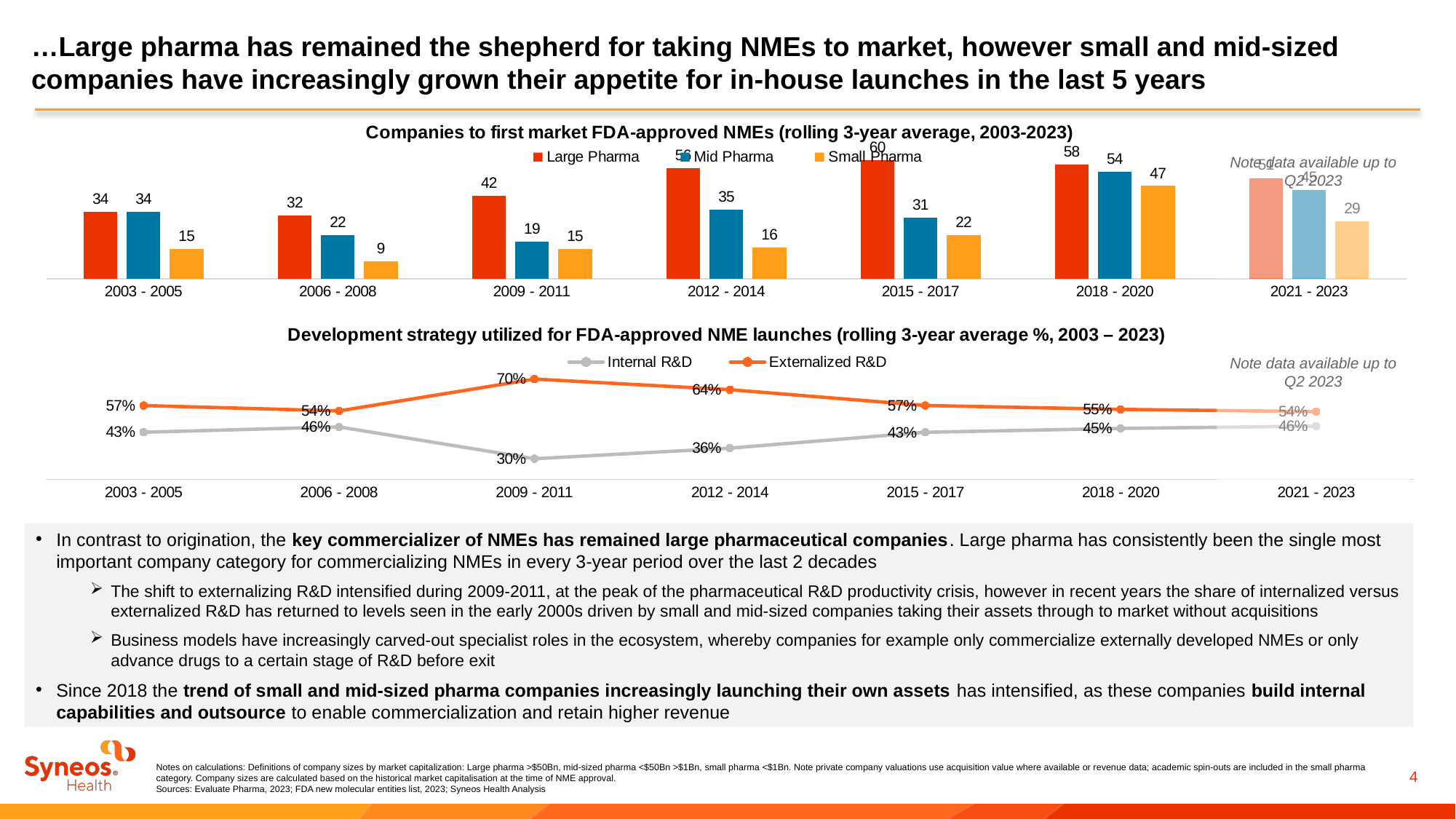
In the 'Companies to first market FDA-approved NMEs' chart, what is the value for Large Pharma in 2015 - 2017? 60 In the 'Development strategy utilized for FDA-approved NME launches' chart, how many periods are shown on the x axis? 7 In the 'Companies to first market FDA-approved NMEs' chart, how many series does the legend list? 3 In the 'Development strategy utilized for FDA-approved NME launches' chart, what is the Externalized R&D value for 2009 - 2011? 70% In the 'Development strategy utilized for FDA-approved NME launches' chart, what is the Internal R&D value for 2012 - 2014? 36% What kind of chart is the 'Companies to first market FDA-approved NMEs' chart? Bar chart In the 'Companies to first market FDA-approved NMEs' chart, what is the value for Mid Pharma in 2018 - 2020? 54 In the 'Development strategy utilized for FDA-approved NME launches' chart, which is larger in 2018 - 2020: Internal R&D or Externalized R&D? Externalized R&D In the 'Companies to first market FDA-approved NMEs' chart, what is the value for Small Pharma in 2006 - 2008? 9 In the 'Companies to first market FDA-approved NMEs' chart, which period has the lowest Small Pharma value? 2006 - 2008 In the 'Development strategy utilized for FDA-approved NME launches' chart, which period has the lowest Internal R&D value? 2009 - 2011 In the 'Companies to first market FDA-approved NMEs' chart, what is the difference between Large Pharma and Small Pharma in 2012 - 2014? 40